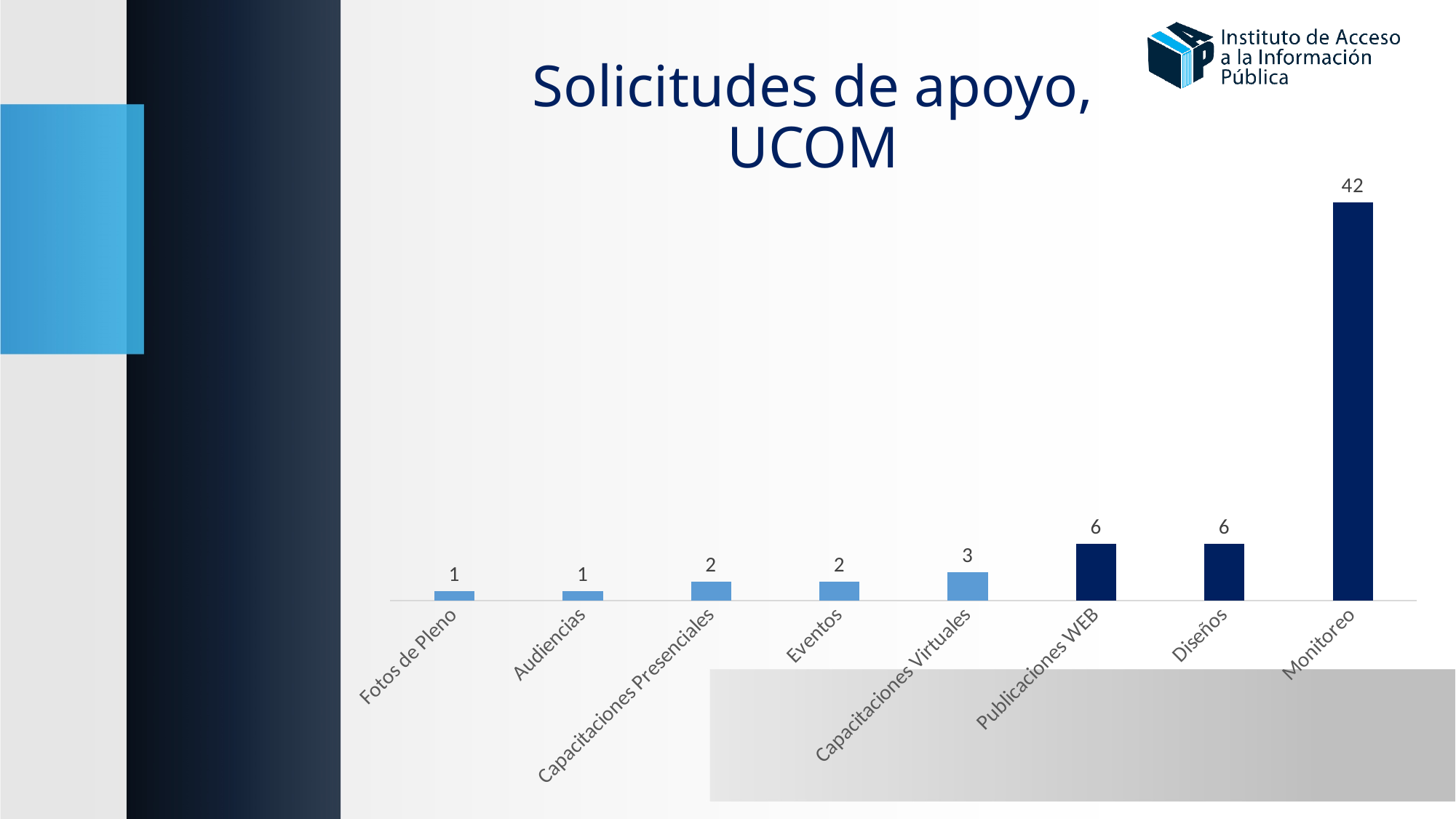
What is the difference between the values for Capacitaciones Virtuales and Eventos? 1 What kind of chart is shown on the slide? Bar chart Do the values generally rise or fall from left to right along the x axis? Rise How many categories are shown in the chart? 8 Which category has the highest value? Monitoreo What is the value for Fotos de Pleno? 1 What is the value for Capacitaciones Virtuales? 3 What is the title of the chart on the slide? Solicitudes de apoyo, UCOM Which is larger, the value for Publicaciones WEB or the value for Capacitaciones Presenciales? Publicaciones WEB What is the difference between the values for Monitoreo and Diseños? 36 What is the value for Publicaciones WEB? 6 What is the value for Monitoreo? 42